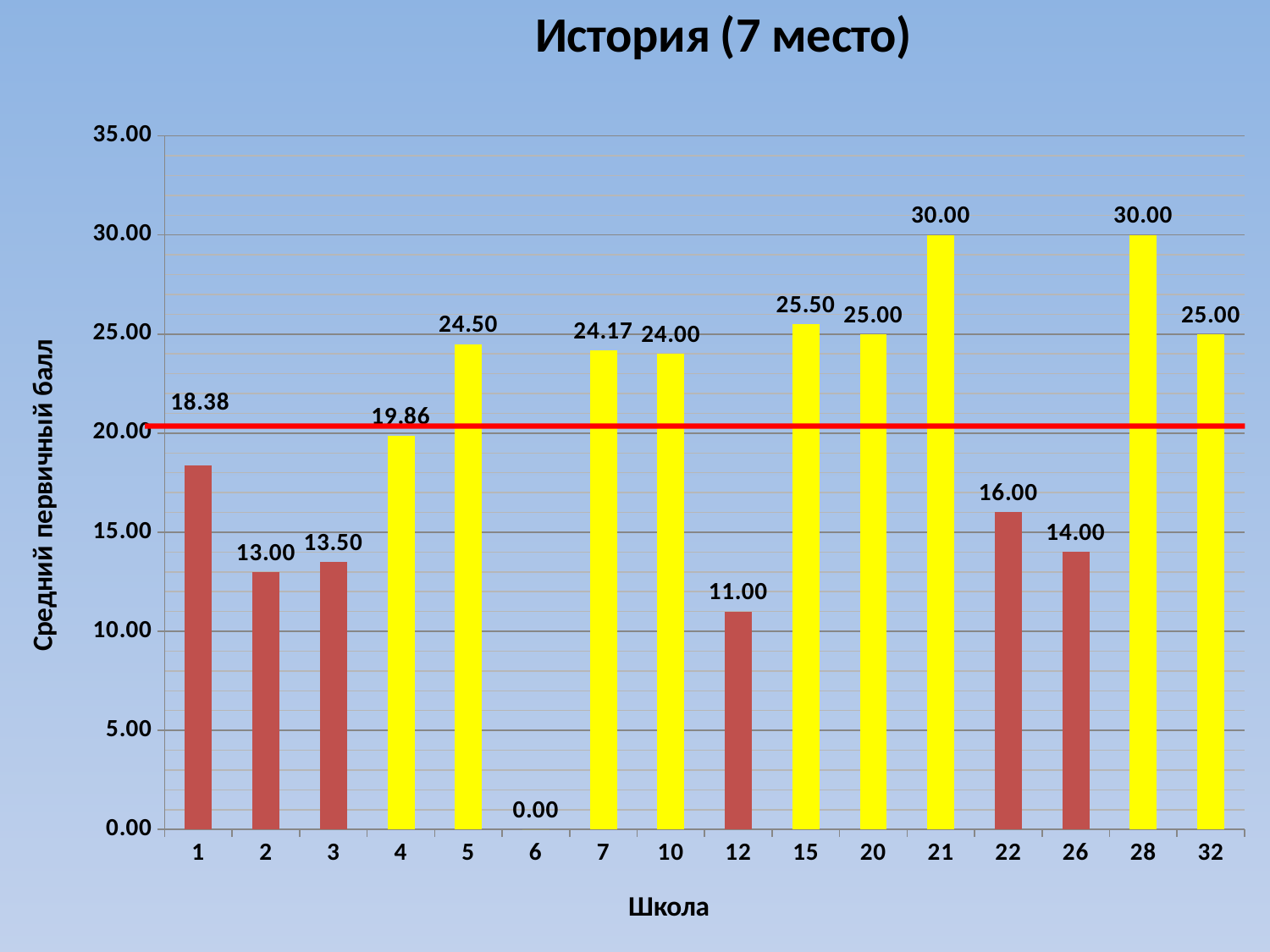
What type of chart is shown on the slide? bar chart What is the value for school 12? 11.00 Which schools share the highest value of 30.00? 21 and 28 What is the value for school 5? 24.50 What is the title of the chart? История (7 место) Is the value for school 4 greater or less than 20.00? less What is the value for school 1? 18.38 How many schools are shown on the x axis? 16 Which school has the lowest value? 6 What is the label of the y axis? Средний первичный балл Which is larger, the value for school 7 or the value for school 10? school 7 What is the difference between the values for school 15 and school 22? 9.50